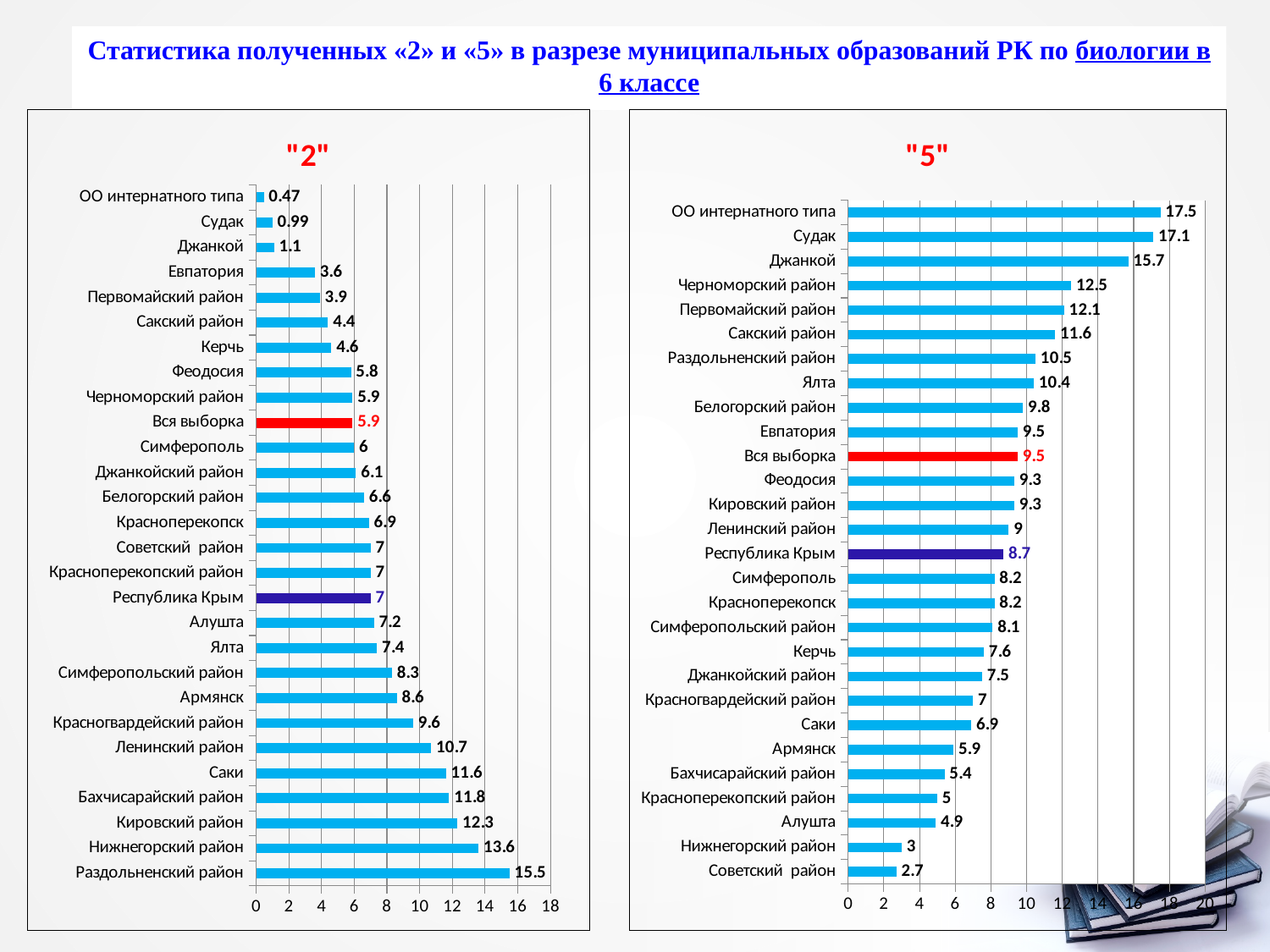
In the chart titled "5", what is the difference between the values for Судак and Джанкой? 1.4 In the chart titled "5", how many categories are plotted? 28 In the chart titled "5", what is the value for Республика Крым? 8.7 What type of chart is the chart titled "2"? Bar chart In the chart titled "2", what is the value for Вся выборка? 5.9 In the chart titled "5", what colour is the bar for Вся выборка? Red In the chart titled "5", which category has the highest value? ОО интернатного типа In the chart titled "5", what is the value for Советский район? 2.7 In the chart titled "2", which is larger, the value for Саки or the value for Ленинский район? Саки In the chart titled "2", which category has the lowest value? ОО интернатного типа In the chart titled "2", what is the value for Раздольненский район? 15.5 In the chart titled "2", what is the difference between the values for Нижнегорский район and Кировский район? 1.3